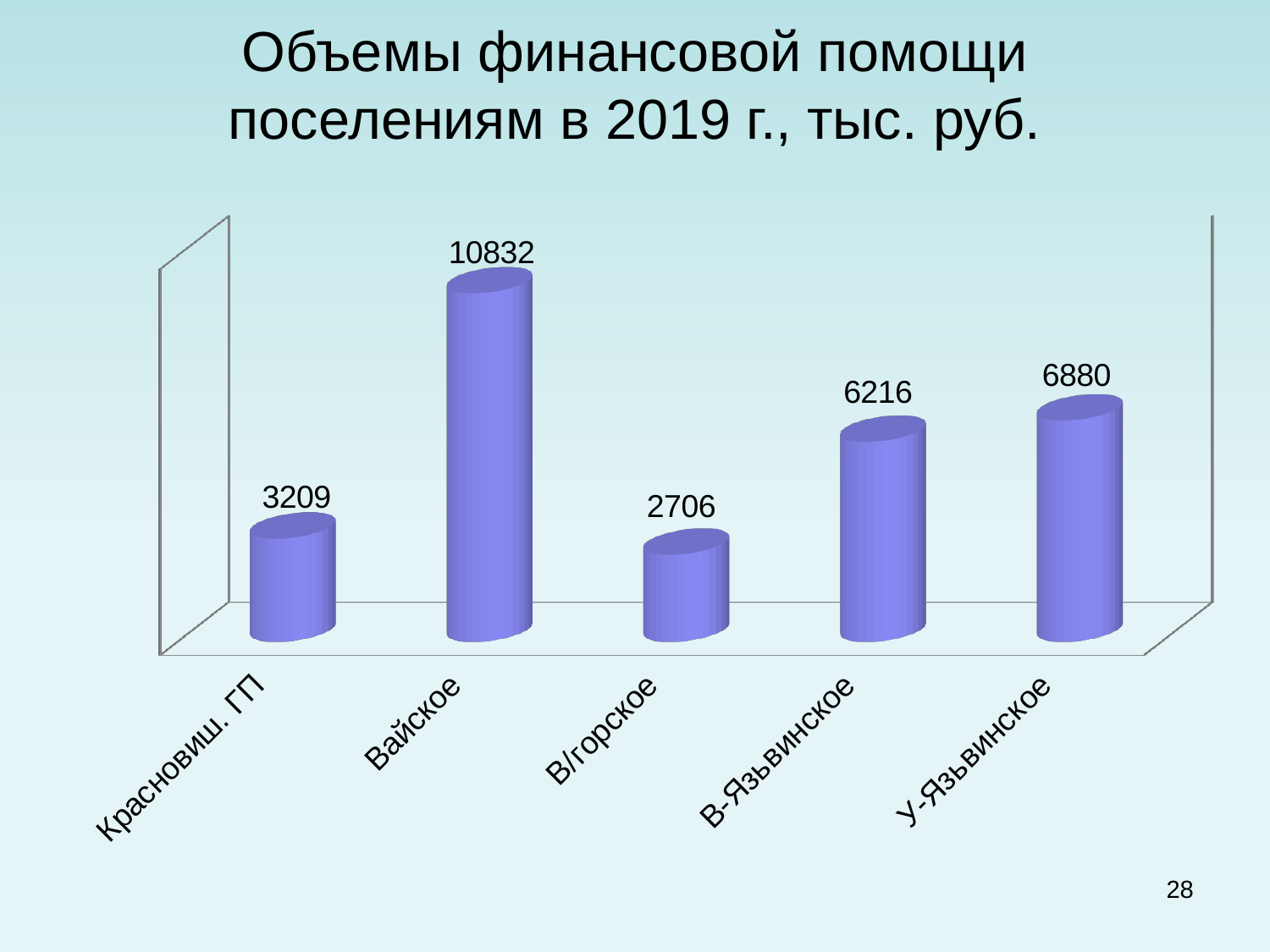
What kind of chart is shown on the slide? Bar chart What is the value for В/горское? 2706 What is the value for Красновиш. ГП? 3209 What is the value for У-Язьвинское? 6880 Which category has the lowest value? В/горское How many categories are shown in the chart? 5 What is the difference between the values for Красновиш. ГП and В/горское? 503 What is the difference between the values for Вайское and У-Язьвинское? 3952 Which category has the highest value? Вайское Which is larger, the value for В-Язьвинское or the value for У-Язьвинское? У-Язьвинское What is the value for Вайское? 10832 What is the value for В-Язьвинское? 6216